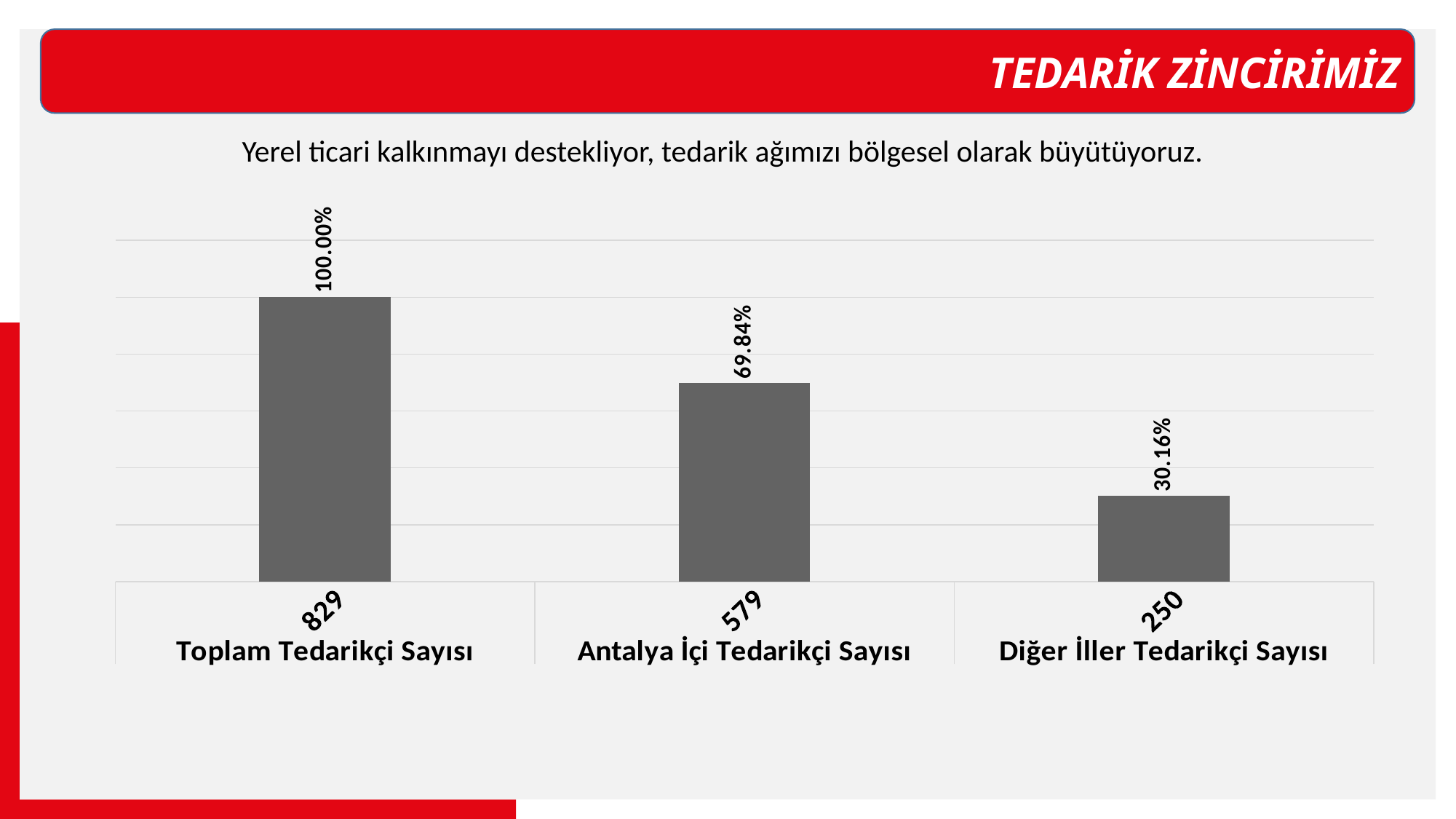
What percentage is shown above the bar for Toplam Tedarikçi Sayısı? 100.00% What number is shown under the Diğer İller Tedarikçi Sayısı category? 250 What percentage is shown above the bar for Antalya İçi Tedarikçi Sayısı? 69.84% What number is shown under the Toplam Tedarikçi Sayısı category? 829 What kind of chart is shown on the slide? Bar chart What number is shown under the Antalya İçi Tedarikçi Sayısı category? 579 Which category has the lowest bar? Diğer İller Tedarikçi Sayısı Which is larger, the value for Antalya İçi Tedarikçi Sayısı or Diğer İller Tedarikçi Sayısı? Antalya İçi Tedarikçi Sayısı What is the difference in percentage points between Antalya İçi Tedarikçi Sayısı and Diğer İller Tedarikçi Sayısı? 39.68 How many categories are shown in the chart? 3 What percentage is shown above the bar for Diğer İller Tedarikçi Sayısı? 30.16% Which category has the highest bar? Toplam Tedarikçi Sayısı